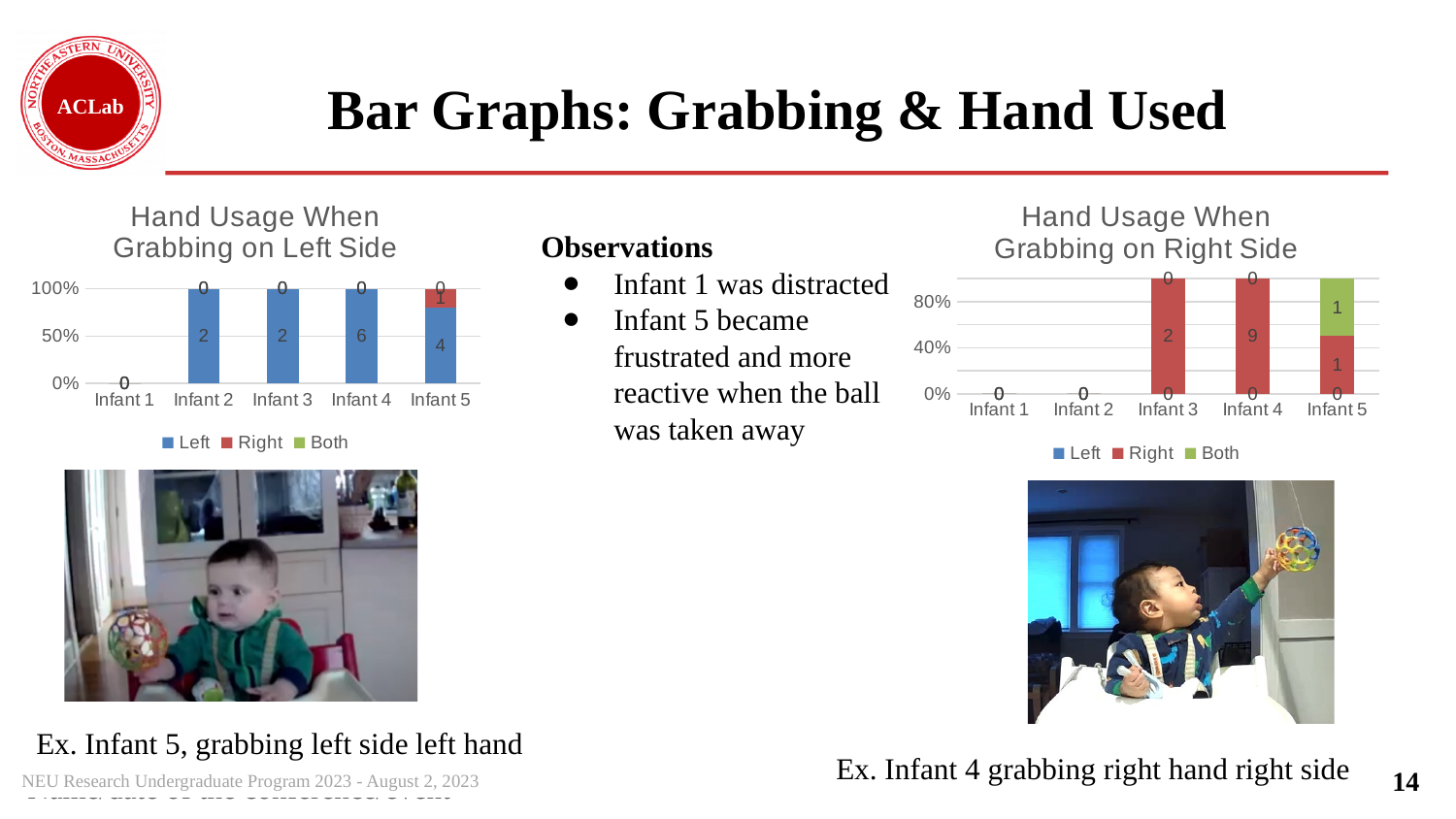
How many series does the legend of the 'Hand Usage When Grabbing on Right Side' chart list? 3 In the 'Hand Usage When Grabbing on Left Side' chart, what is the Left value for Infant 4? 6 In the 'Hand Usage When Grabbing on Left Side' chart, which infant has the highest Left value? Infant 4 In the 'Hand Usage When Grabbing on Left Side' chart, what is the Left value for Infant 2? 2 In the 'Hand Usage When Grabbing on Right Side' chart, what is the Right value for Infant 3? 2 In the 'Hand Usage When Grabbing on Left Side' chart, what is the difference between the Left values for Infant 4 and Infant 5? 2 What kind of chart is 'Hand Usage When Grabbing on Right Side'? Stacked bar chart In the 'Hand Usage When Grabbing on Right Side' chart, what is the Both value for Infant 5? 1 In the 'Hand Usage When Grabbing on Left Side' chart, what is the Right value for Infant 5? 1 How many infants are shown on the x axis of the 'Hand Usage When Grabbing on Left Side' chart? 5 In the 'Hand Usage When Grabbing on Right Side' chart, what is the Right value for Infant 4? 9 In the 'Hand Usage When Grabbing on Right Side' chart, which infant has the highest Right value? Infant 4